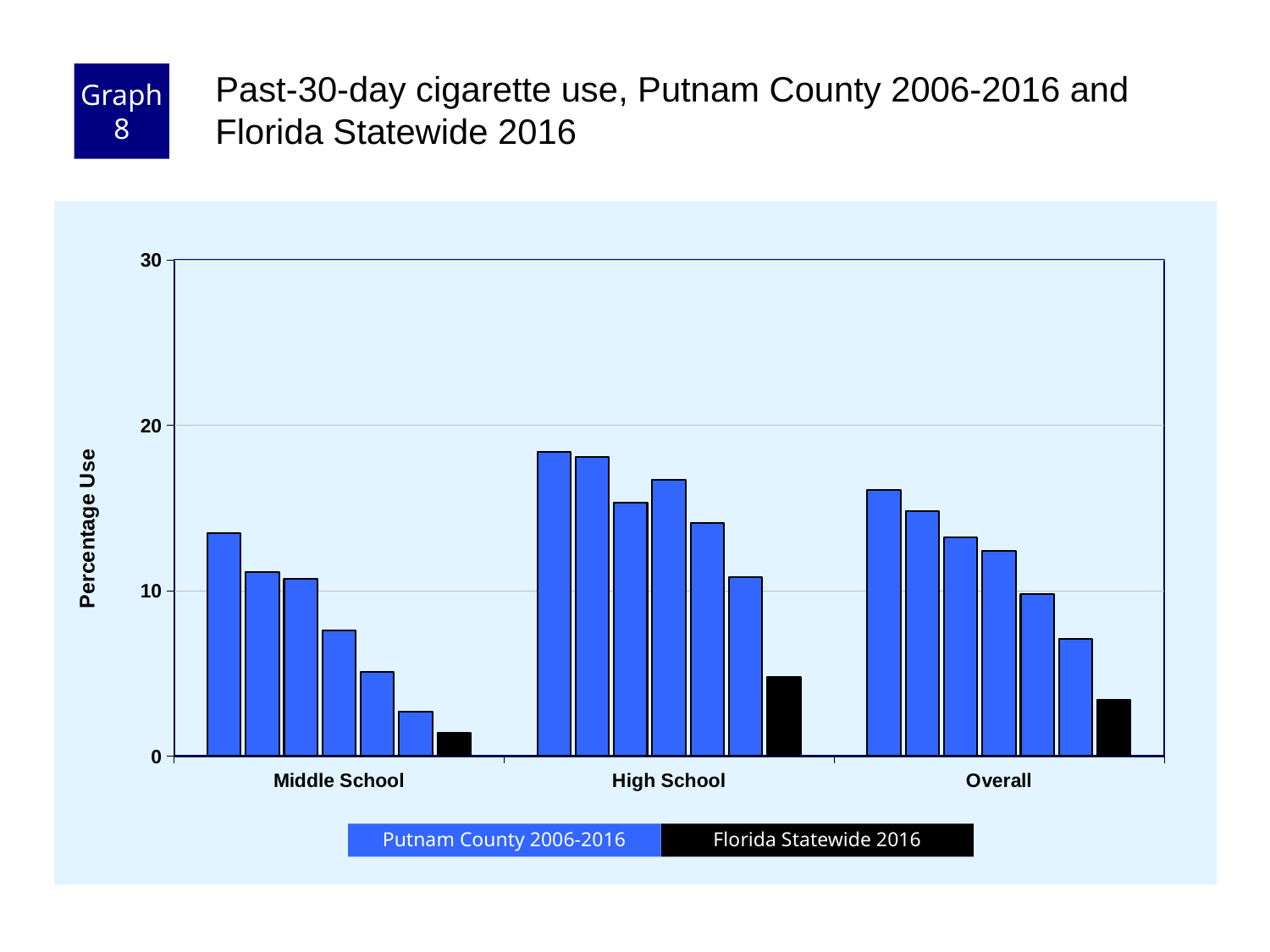
Is the Florida Statewide 2016 value for Middle School greater or less than 10? less Is the first Putnam County bar for Middle School greater or less than 10? greater What kind of chart is shown on the slide? bar chart Which colour represents Florida Statewide 2016 in the chart? black Which category has the tallest bars overall? High School Is the tallest Putnam County bar for High School greater or less than 20? less Within the Middle School category, do the Putnam County 2006-2016 bars generally rise or fall from left to right? fall In the Overall category, is the Florida Statewide 2016 bar taller or shorter than every Putnam County 2006-2016 bar? shorter What is the label of the y axis? Percentage Use How many categories are shown on the x axis of the chart? 3 How many series does the chart's legend list? 2